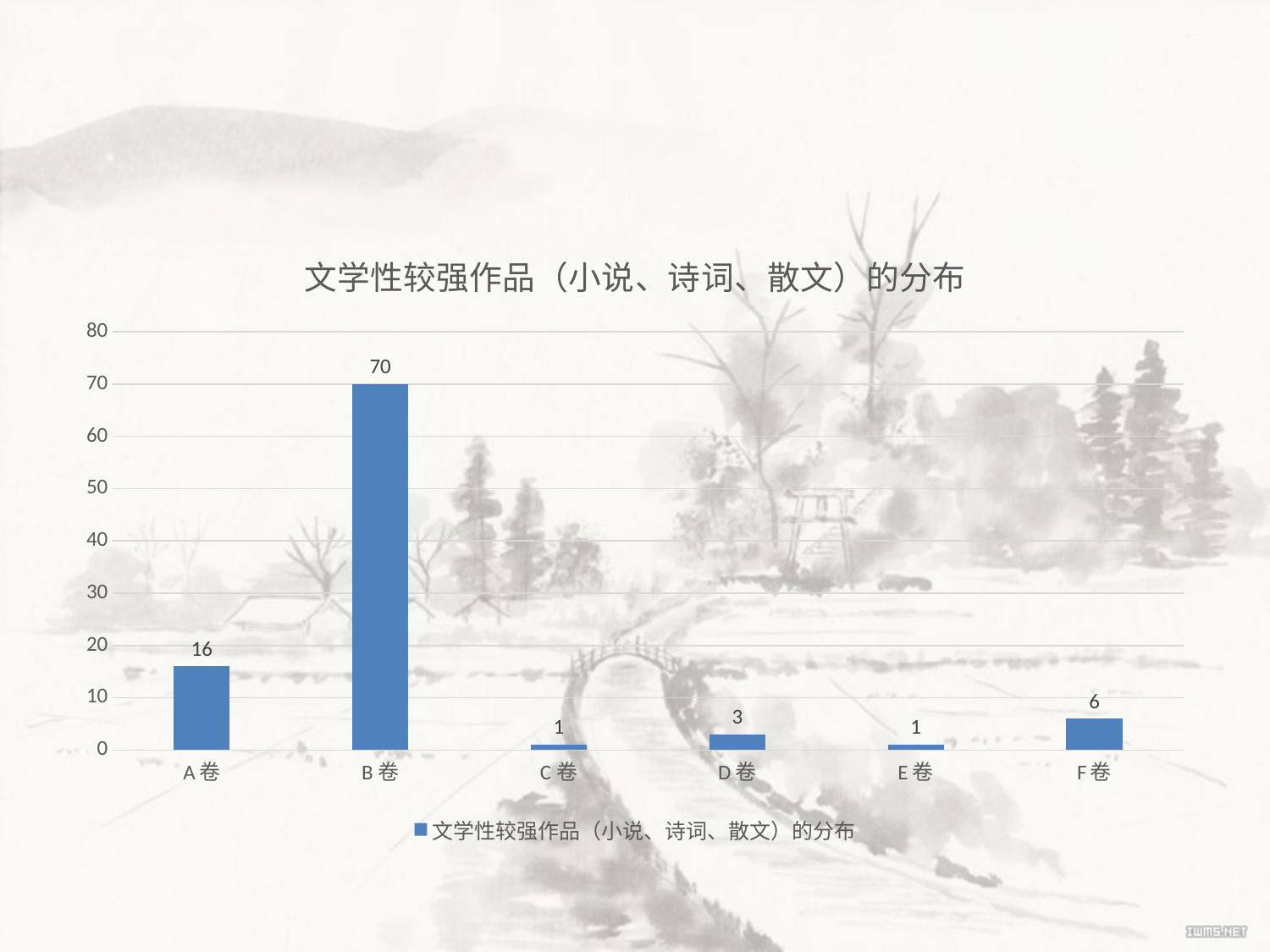
Is the value for B 卷 greater or less than 60? greater What is the title of the chart? 文学性较强作品（小说、诗词、散文）的分布 Which is larger, the value for F 卷 or the value for D 卷? F 卷 What kind of chart is shown on the slide? bar chart What is the value for B 卷? 70 How many series does the legend list? 1 Which category has the highest value? B 卷 What is the difference between the values for B 卷 and A 卷? 54 What is the value for A 卷? 16 How many categories are shown on the x axis? 6 What is the value for D 卷? 3 What is the value for F 卷? 6